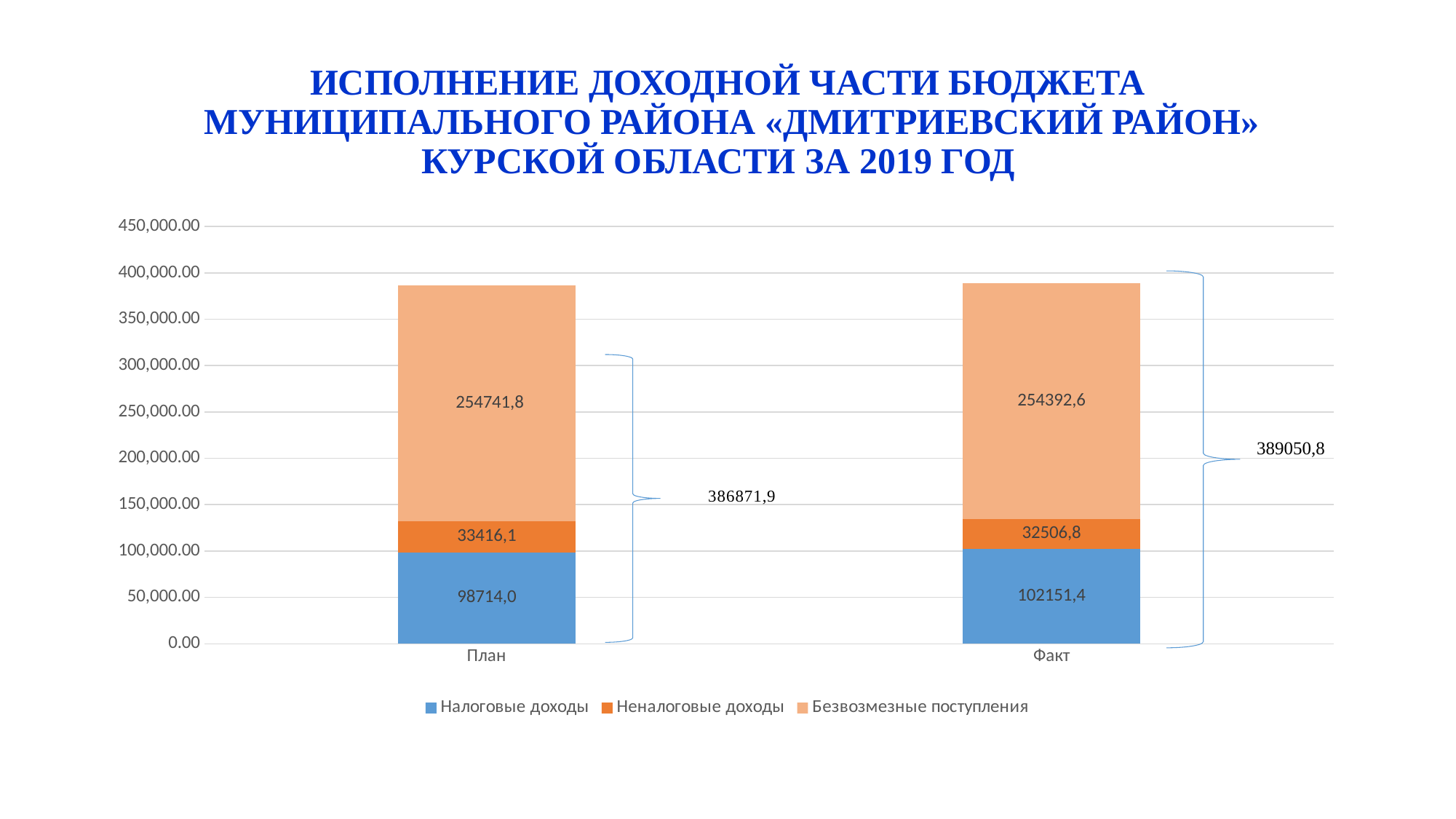
What is the value of Налоговые доходы for Факт? 102151,4 Is Налоговые доходы larger for План or for Факт? Факт What is the total shown for the План bar? 386871,9 What is the value of Неналоговые доходы for Факт? 32506,8 Which series has the smallest value in the План bar? Неналоговые доходы What is the difference between Неналоговые доходы for План and for Факт? 909,3 Which series has the largest value in the Факт bar? Безвозмезные поступления What kind of chart is shown on the slide? Stacked bar chart What is the value of Налоговые доходы for План? 98714,0 What is the value of Безвозмездные поступления for План? 254741,8 What is the total shown for the Факт bar? 389050,8 How many series does the legend list? 3